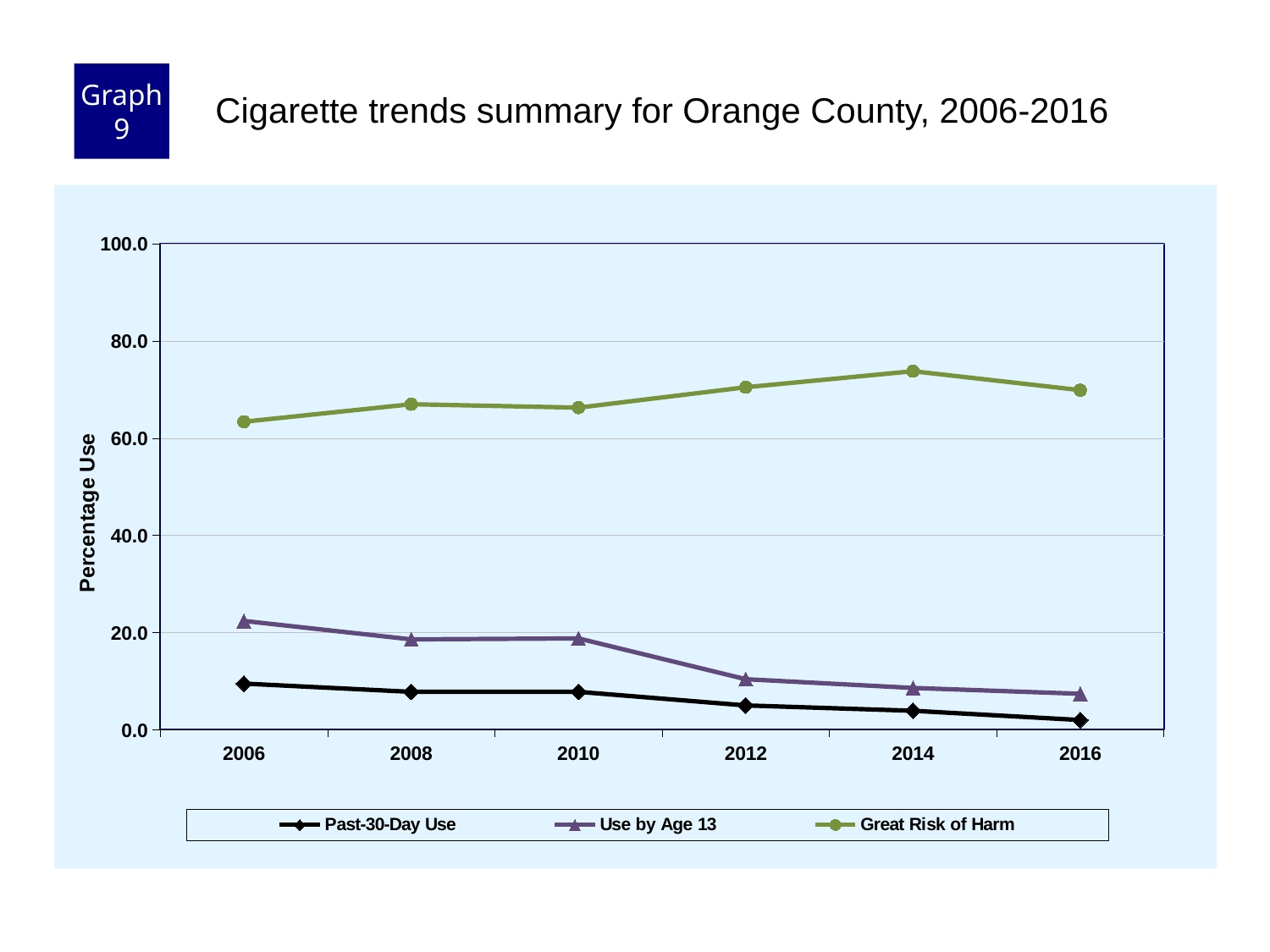
Does the Past-30-Day Use series rise or fall from 2006 to 2016? fall In which year is the Great Risk of Harm series at its highest? 2014 What is the label on the y axis? Percentage Use Is the value for Use by Age 13 in 2012 greater or less than 20.0? less What kind of chart is shown on the slide? line chart How many years are plotted along the x axis? 6 Is the value for Use by Age 13 in 2006 greater or less than 20.0? greater How many series does the legend list? 3 In 2006, which is larger: Use by Age 13 or Past-30-Day Use? Use by Age 13 Is the value for Great Risk of Harm in 2006 greater or less than 60.0? greater In which year is the Use by Age 13 series at its lowest? 2016 What is the title of the chart? Cigarette trends summary for Orange County, 2006-2016